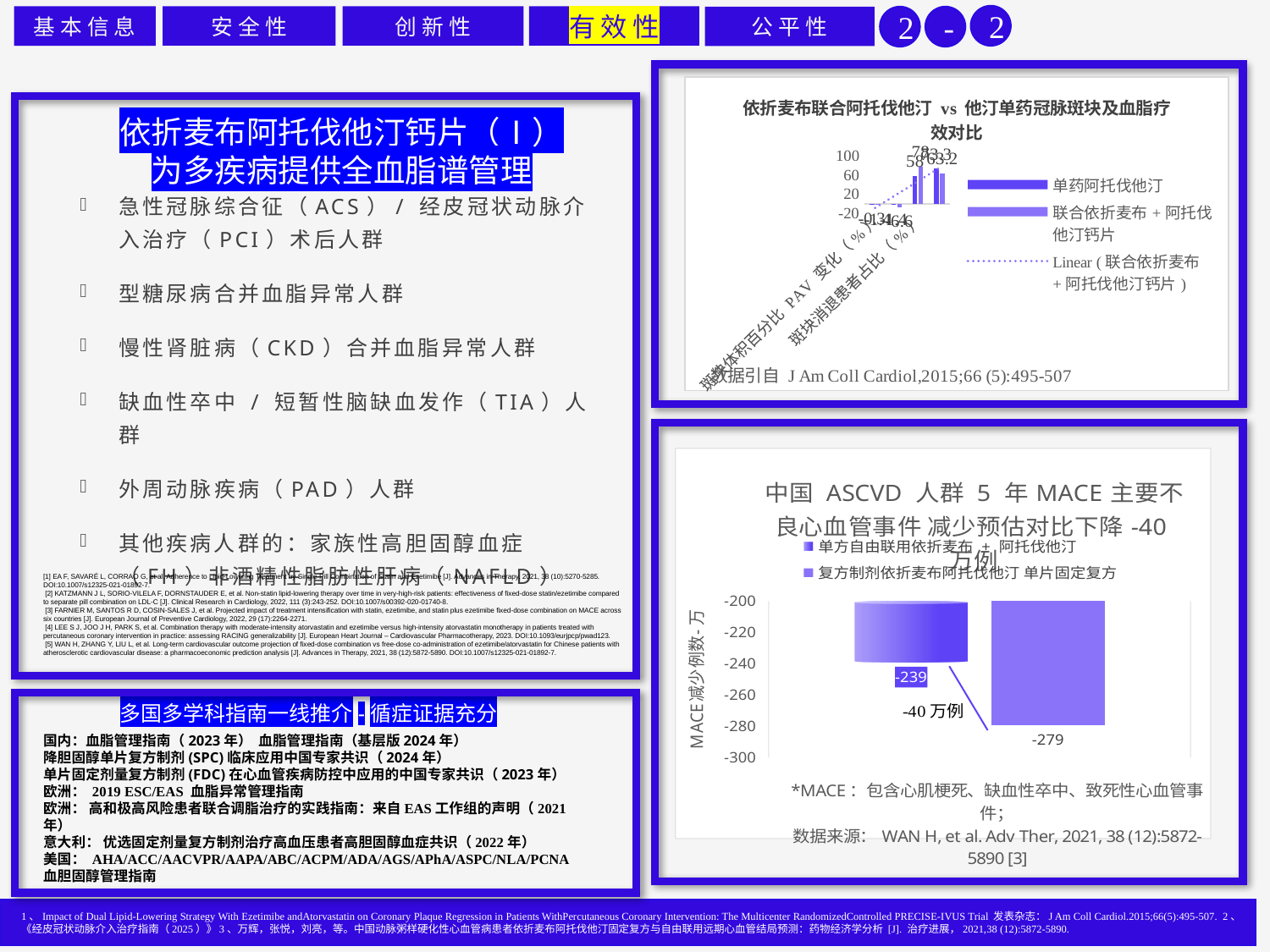
In the bottom-right MACE chart, what is the difference between the values for the single-pill fixed-dose combination (-279) and the free combination (-239)? 40 In the top-right chart comparing ezetimibe plus atorvastatin vs statin monotherapy, how many entries does the legend list? 3 What kind of chart is the top-right chart titled 依折麦布联合阿托伐他汀 vs 他汀单药冠脉斑块及血脂疗效对比? bar chart In the bottom-right MACE chart, which series has the larger reduction in MACE cases: 单方自由联用依折麦布 + 阿托伐他汀 or 复方制剂依折麦布阿托伐他汀 单片固定复方? 复方制剂依折麦布阿托伐他汀 单片固定复方 In the top-right chart, which legend entry is shown as a dotted line rather than a bar? Linear (联合依折麦布 + 阿托伐他汀钙片) In the bottom-right MACE chart, how many series does the legend list? 2 In the bottom-right chart about 5-year MACE reduction in the Chinese ASCVD population, what is the value for 单方自由联用依折麦布 + 阿托伐他汀? -239 In the bottom-right chart about 5-year MACE reduction in the Chinese ASCVD population, what is the value for 复方制剂依折麦布阿托伐他汀 单片固定复方? -279 In the bottom-right MACE chart, is the value for 复方制剂依折麦布阿托伐他汀 单片固定复方 greater or less than -260? less In the top-right chart, what is the highest tick value shown on the vertical axis? 100 What kind of chart is the bottom-right chart about 5-year MACE reduction? bar chart In the bottom-right MACE chart, what is the label of the vertical axis? MACE减少例数-万